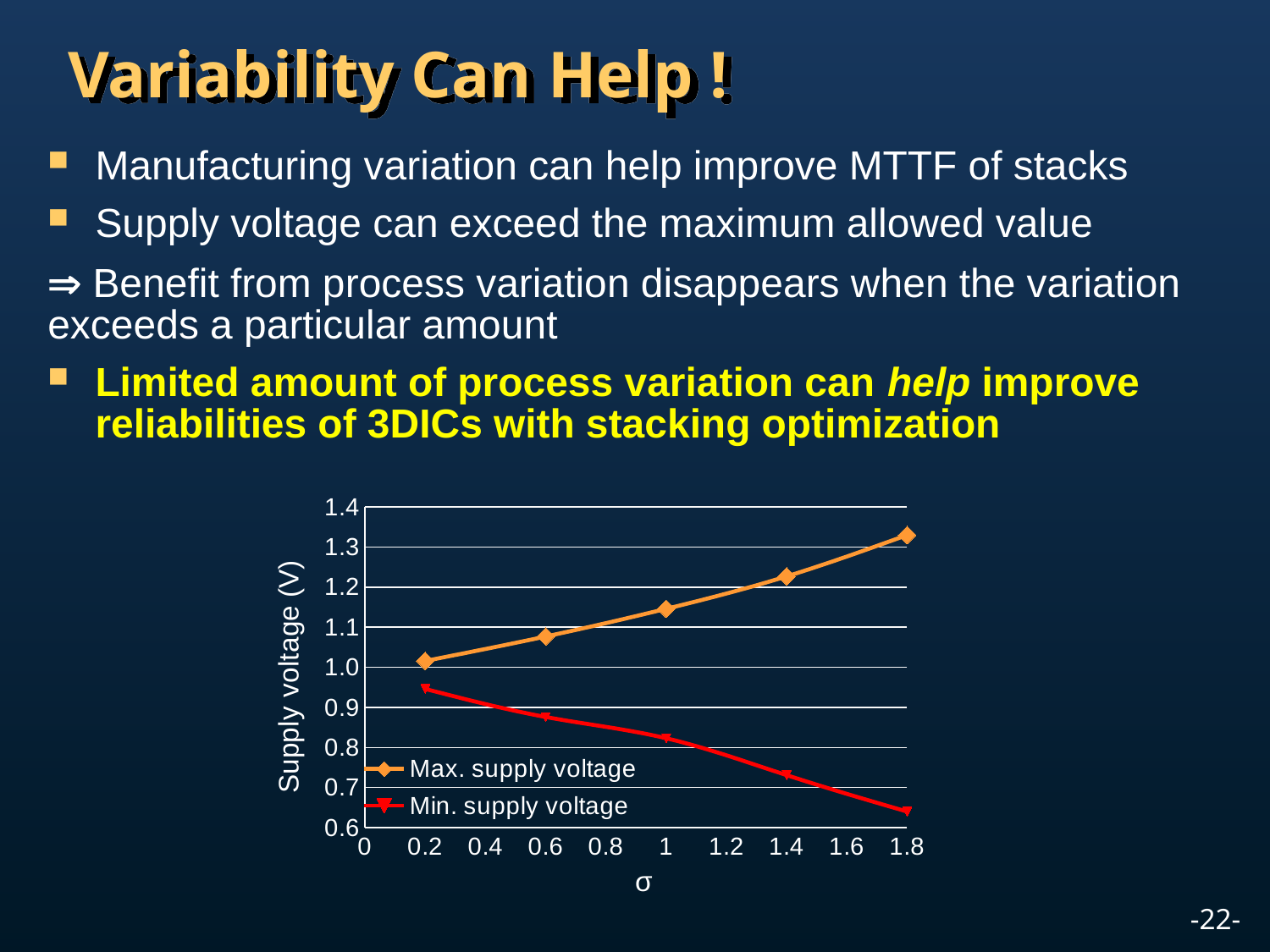
What kind of chart is shown on the slide? Line chart Is the Max. supply voltage at σ = 1.8 greater or less than 1.3? greater Does the Max. supply voltage rise or fall as σ increases? Rises Is the Min. supply voltage at σ = 1.8 greater or less than 0.7? less What is the label of the chart's vertical axis? Supply voltage (V) How many series does the chart's legend list? 2 Is the Max. supply voltage at σ = 1 greater or less than 1.1? greater Does the Min. supply voltage rise or fall as σ increases? Falls At σ = 1, which series has the larger value, Max. supply voltage or Min. supply voltage? Max. supply voltage How many data points are plotted for the Max. supply voltage series? 5 What is the label of the chart's horizontal axis? σ